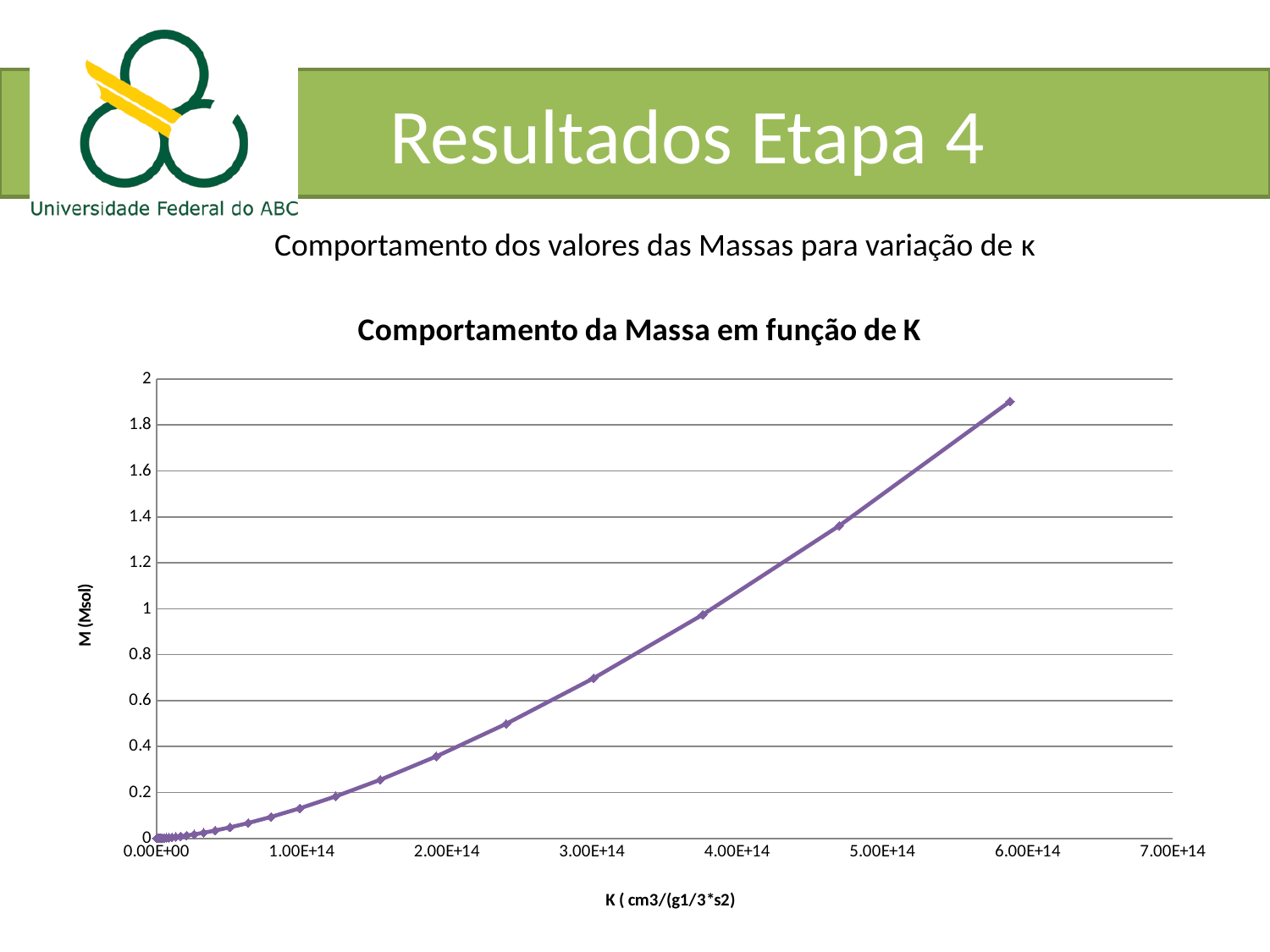
Is the value of M at the plotted point near K = 2.40E+14 greater or less than 0.4? greater Is the value of M at the plotted point near K = 3.00E+14 greater or less than 0.8? less What is the label of the vertical axis of the chart? M (Msol) Is the value of M at the plotted point near K = 4.70E+14 greater or less than 1.2? greater At which end of the x axis does the curve reach its lowest value of M? at K = 0.00E+00 What kind of chart is shown on the slide? line chart Which plotted point has the highest value of M: the one near K = 3.80E+14 or the one near K = 5.90E+14? the one near K = 5.90E+14 What is the title of the chart? Comportamento da Massa em função de K Do the values of M rise or fall as K increases along the x axis? rise What is the highest value shown on the vertical axis of the chart? 2